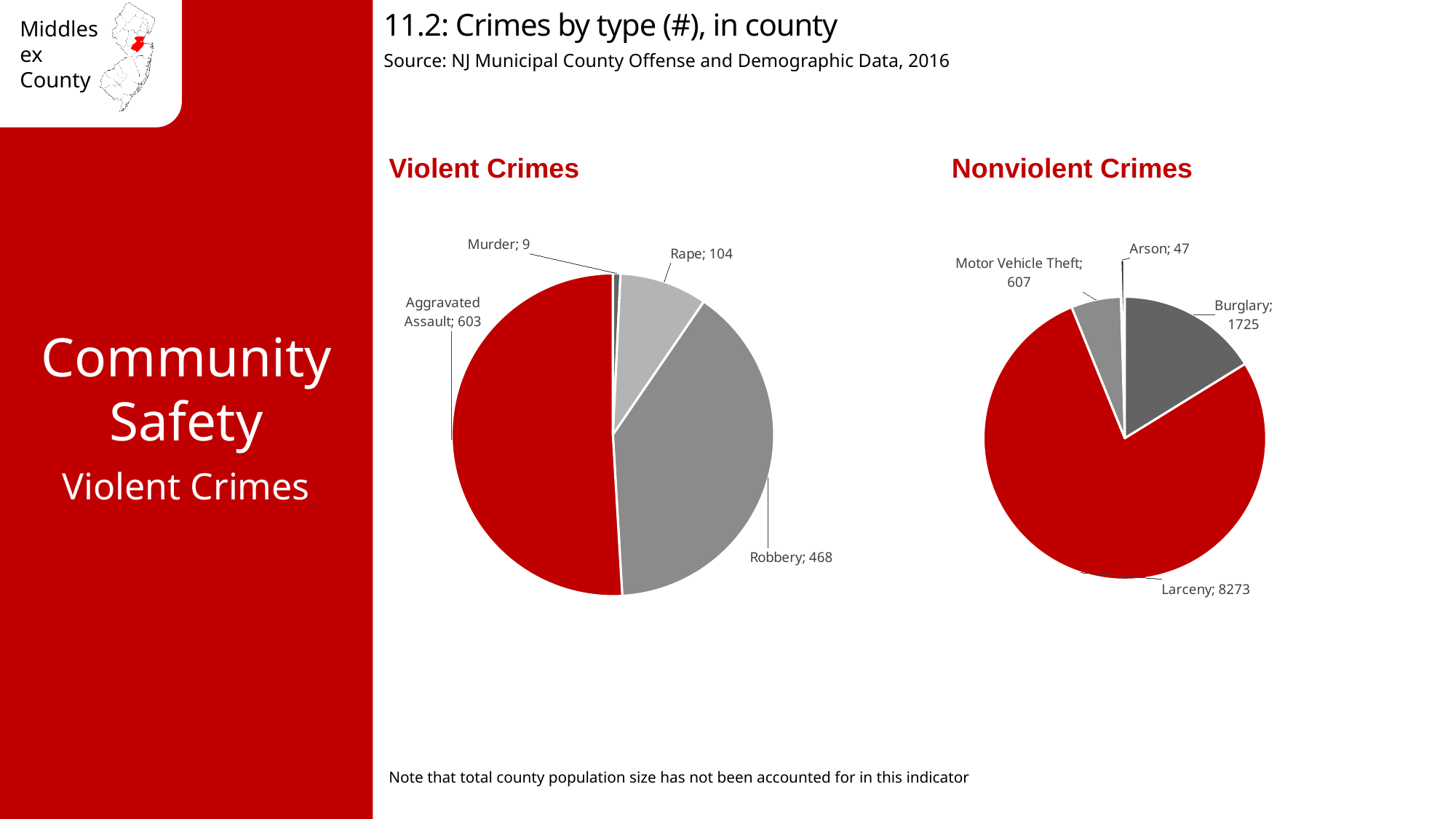
How many crime types are shown in the Nonviolent Crimes chart? 4 What is the total of all values in the Violent Crimes chart? 1184 In the Nonviolent Crimes chart, which crime type has the smallest slice? Arson In the Violent Crimes chart, what is the difference between Aggravated Assault and Robbery? 135 In the Violent Crimes chart, how many robberies are shown? 468 What kind of chart is the Violent Crimes chart? Pie chart In the Violent Crimes chart, which is larger, Rape or Murder? Rape In the Violent Crimes chart, which crime type has the largest slice? Aggravated Assault What is the source cited for the charts on this slide? NJ Municipal County Offense and Demographic Data, 2016 In the Nonviolent Crimes chart, what is the value for Burglary? 1725 In the Nonviolent Crimes chart, what is the difference between Burglary and Motor Vehicle Theft? 1118 In the Nonviolent Crimes chart, what is the value for Larceny? 8273